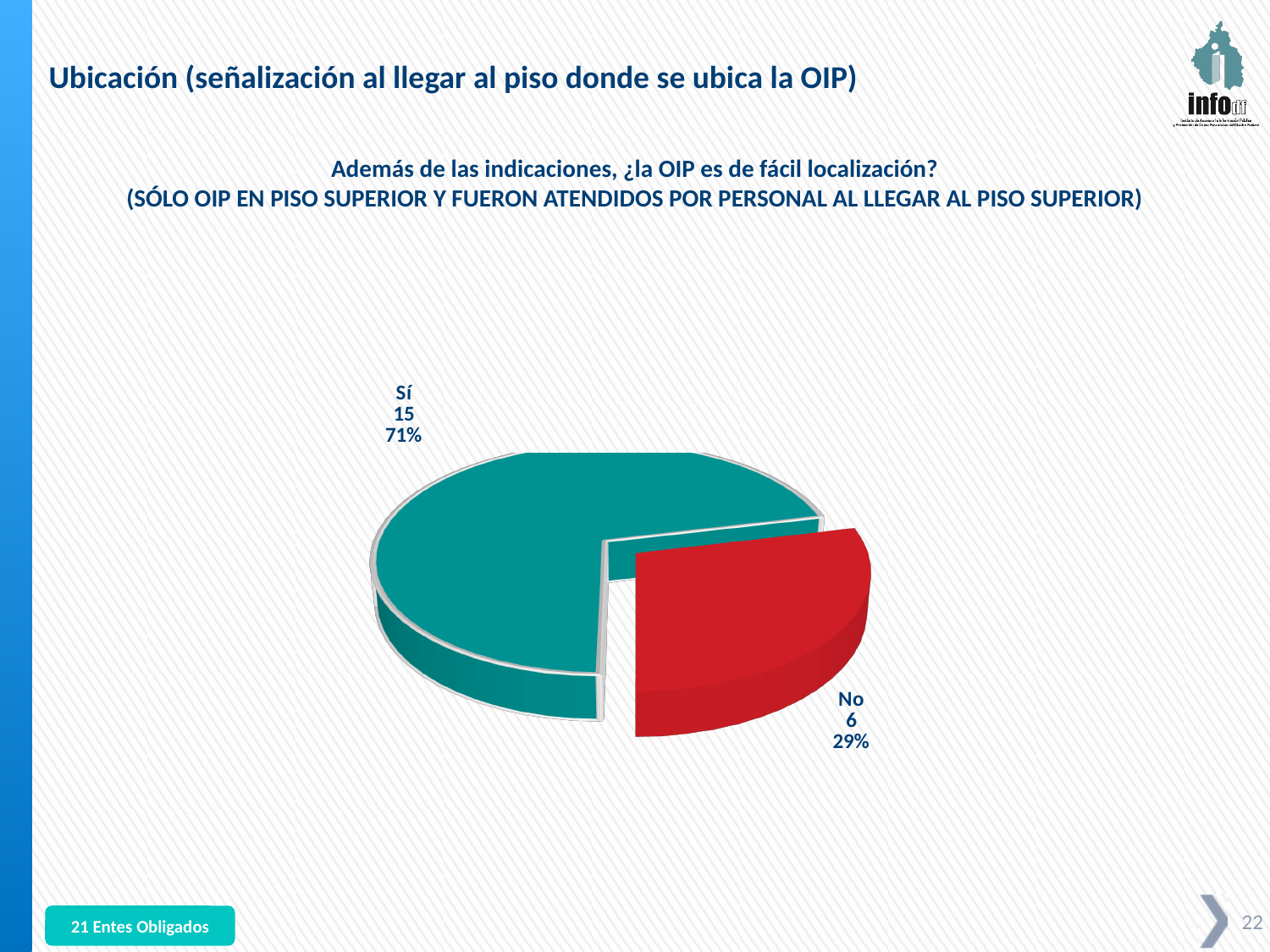
Which slice is the smallest? No What is the count for the 'Sí' slice? 15 Which slice is the largest? Sí What percentage share does the 'Sí' slice represent? 71% How many slices does the pie chart have? 2 Which is larger, the 'Sí' slice or the 'No' slice? Sí What is the difference between the counts for 'Sí' and 'No'? 9 What percentage share does the 'No' slice represent? 29% What is the total of the two slice counts? 21 What colour is the 'No' slice? red What kind of chart is shown on the slide? pie chart What is the count for the 'No' slice? 6